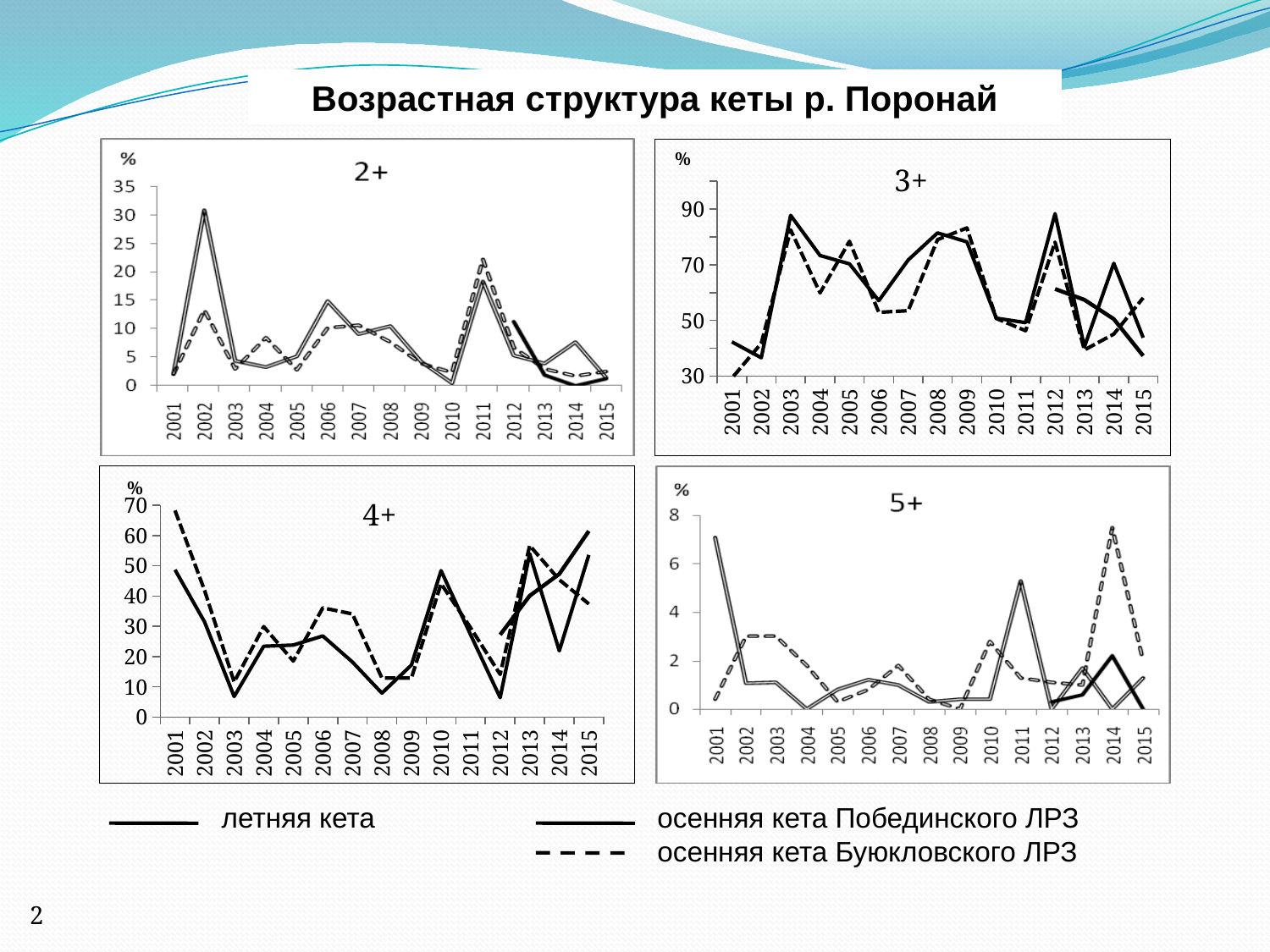
In the "3+" chart, is the value for осенняя кета Буюкловского ЛРЗ in 2009 greater or less than 70? greater In the "4+" chart, is the value for осенняя кета Побединского ЛРЗ in 2015 greater or less than 50? greater In the "3+" chart, is the value for осенняя кета Побединского ЛРЗ in 2013 greater or less than 50? less In the "2+" chart, in which year does the летняя кета series reach its highest value? 2012 What kind of chart is the "2+" chart? line chart How many series does the legend at the bottom of the slide list? 3 In the "4+" chart, in which year does the осенняя кета Буюкловского ЛРЗ series reach its highest value? 2001 In the "5+" chart, in which year does the осенняя кета Буюкловского ЛРЗ series reach its highest value? 2014 How many years are plotted along the x axis of the "4+" chart? 15 How many charts are shown on the slide? 4